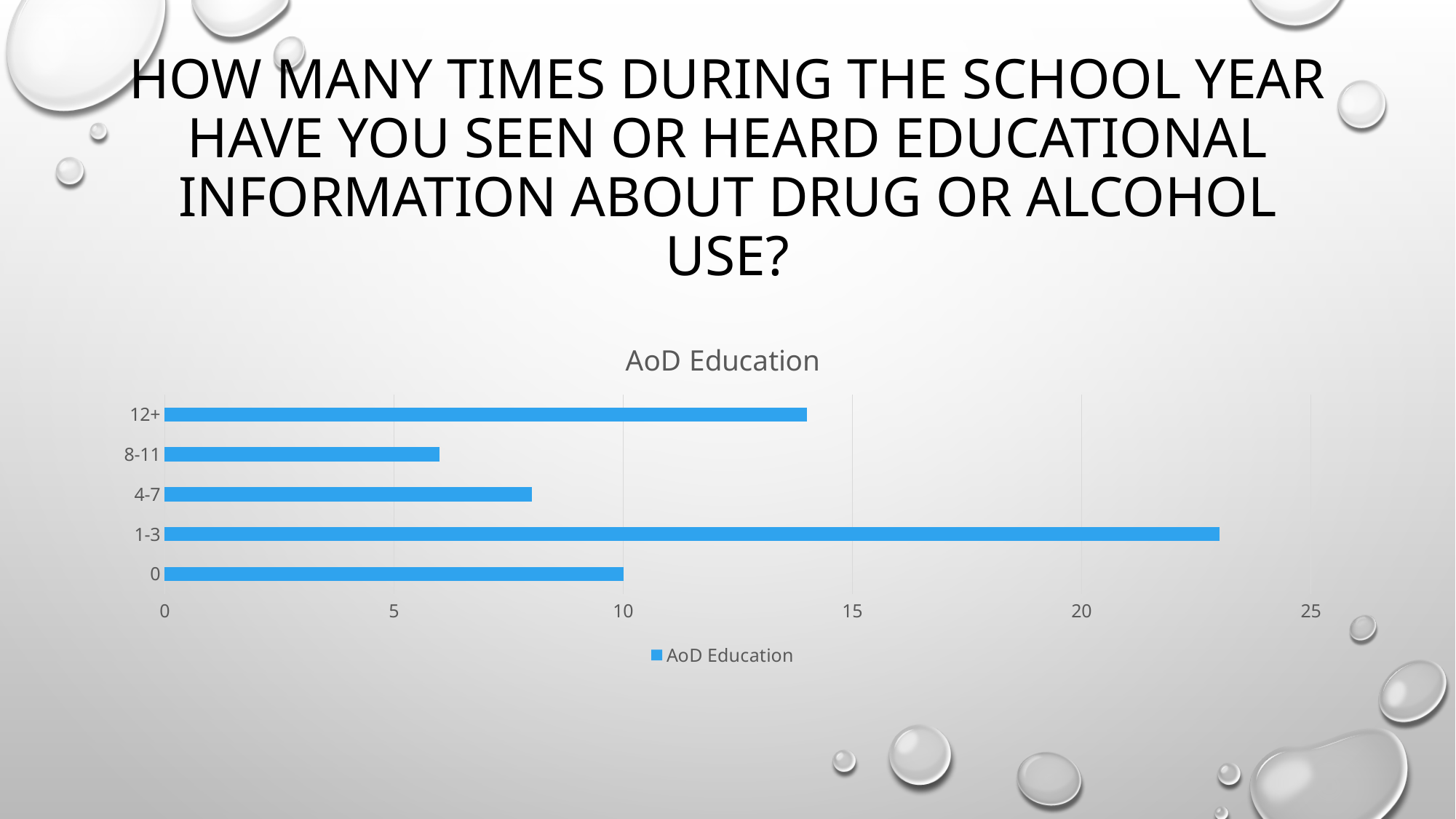
Which is larger, the value for 12+ or the value for 4-7? 12+ Is the value for 4-7 greater or less than 10? less Is the value for 1-3 greater or less than 20? greater What type of chart is shown on the slide? bar chart What is the title of the chart? AoD Education Which category has the lowest value? 8-11 How many categories are shown on the chart? 5 How many series does the legend list? 1 What is the value for the category 0? 10 Which category has the highest value? 1-3 Is the value for 12+ greater or less than 15? less Which is larger, the value for 0 or the value for 8-11? 0